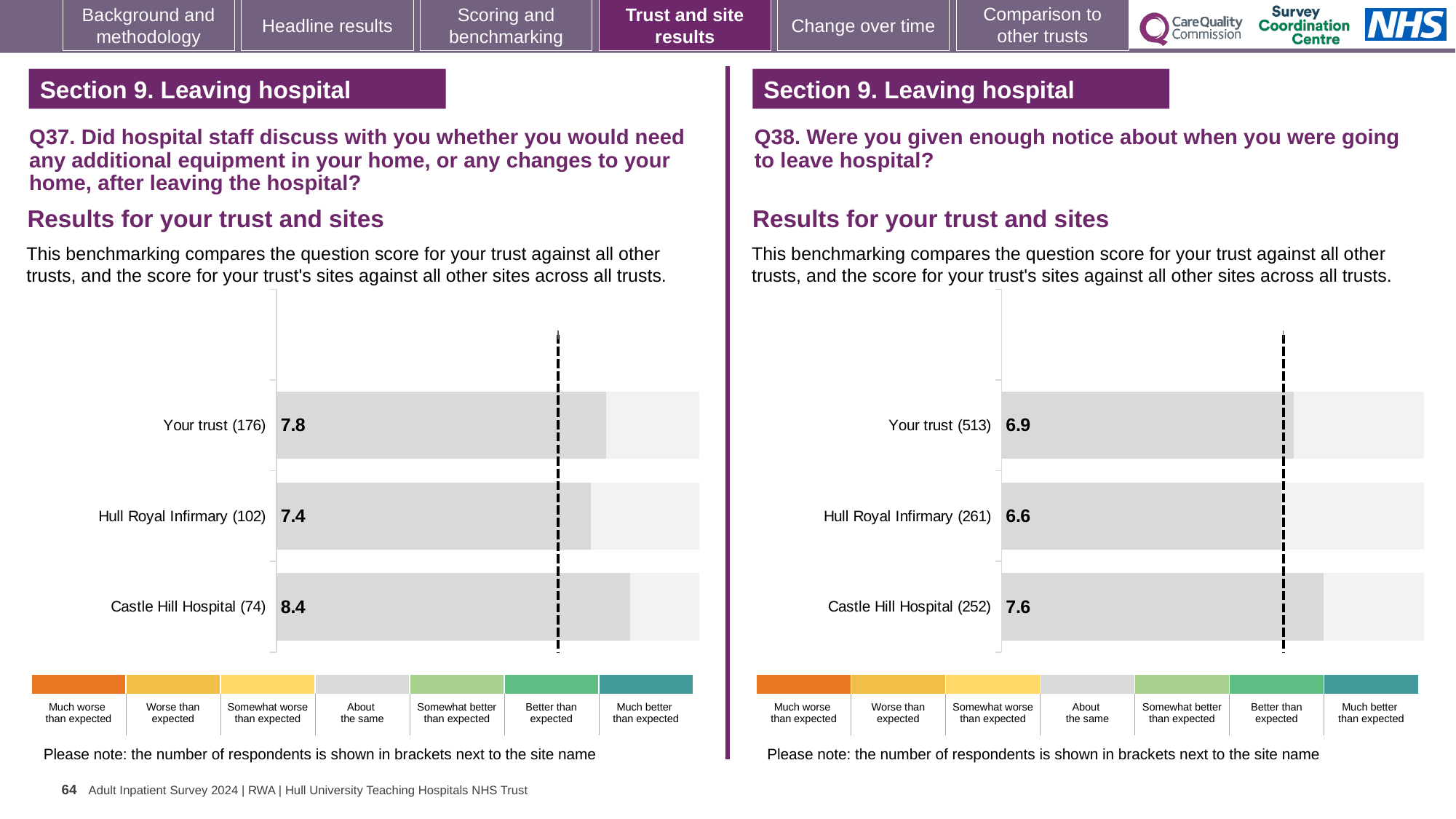
In the Q37 chart on the left, what is the difference between the scores for Castle Hill Hospital and Hull Royal Infirmary? 1.0 In the Q38 chart on the right, what is the difference between the scores for Castle Hill Hospital and Your trust? 0.7 In the Q37 chart on the left, how many respondents are shown in brackets for Hull Royal Infirmary? 102 How many sites or trusts are plotted in the Q37 chart on the left? 3 In the Q37 chart on the left, which site or trust has the highest score? Castle Hill Hospital In the Q38 chart on the right, what is the score for Hull Royal Infirmary? 6.6 What kind of chart is used in the Q38 chart on the right? Bar chart In the Q38 chart on the right, which has the larger score, Your trust or Castle Hill Hospital? Castle Hill Hospital In the Q37 chart on the left, what is the score for Your trust? 7.8 In the Q38 chart on the right, which site or trust has the lowest score? Hull Royal Infirmary In the Q38 chart on the right, what is the score for Your trust? 6.9 In the Q37 chart on the left, what is the score for Castle Hill Hospital? 8.4